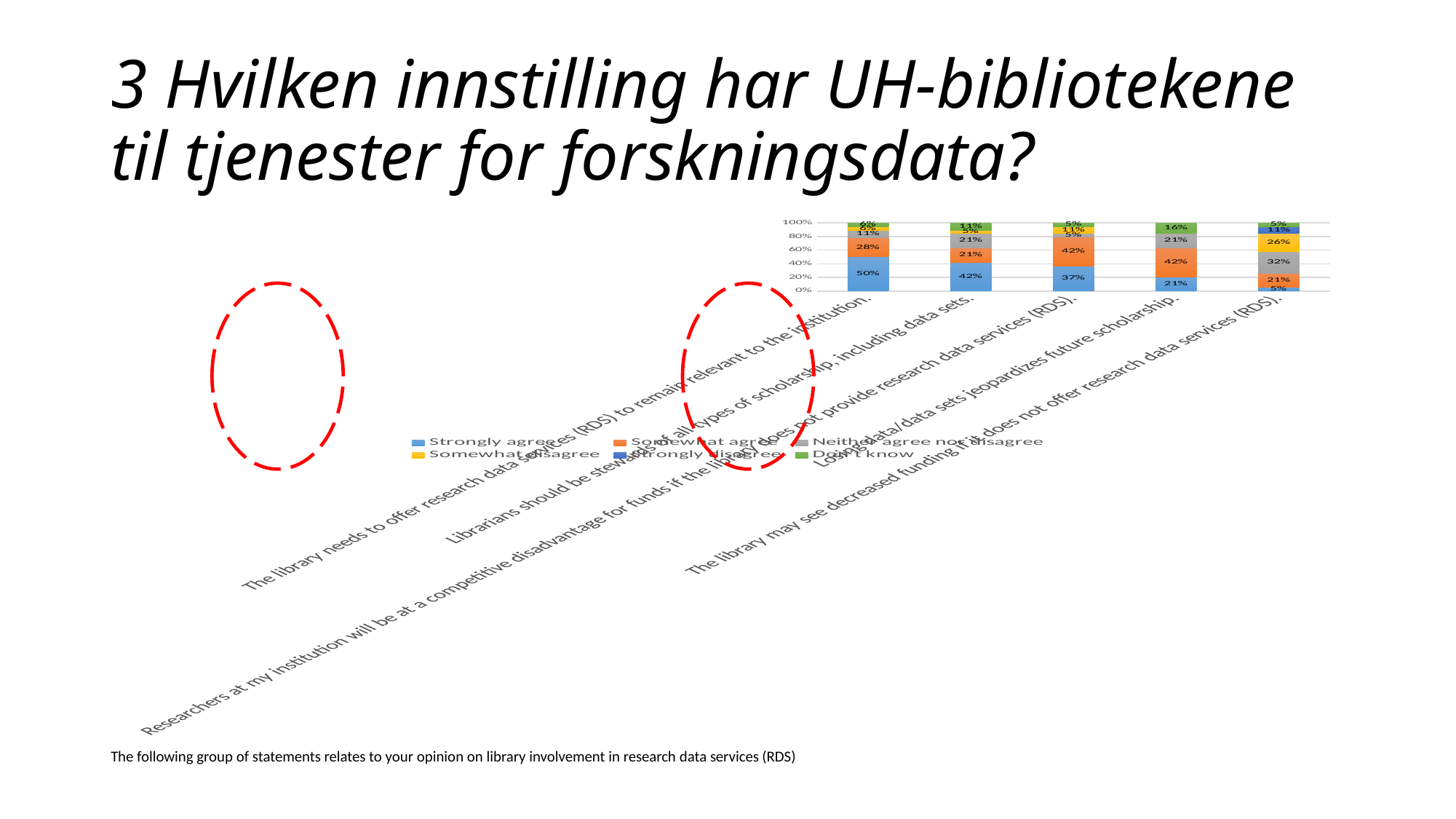
What is the Strongly agree value for the statement "The library may see decreased funding if it does not offer research data services (RDS)"? 5% What is the Neither agree nor disagree value for the statement "The library may see decreased funding if it does not offer research data services (RDS)"? 32% Which statement has the lowest Strongly agree share? The library may see decreased funding if it does not offer research data services (RDS). What percentage of respondents strongly agree that the library needs to offer research data services (RDS) to remain relevant to the institution? 50% What is the Don't know value for the statement "Loss of data/data sets jeopardizes future scholarship"? 16% What kind of chart is shown on the slide? Stacked bar chart Which statement has the highest Strongly agree share? The library needs to offer research data services (RDS) to remain relevant to the institution. How many statements (categories) are shown in the chart? 5 What is the Somewhat agree value for the statement "Loss of data/data sets jeopardizes future scholarship"? 42% How many response options does the legend list? 6 How many percentage points higher is the Strongly agree share for "The library needs to offer research data services (RDS) to remain relevant to the institution" than for "Librarians should be stewards of all types of scholarship, including data sets"? 8 percentage points Which statement has the larger Somewhat agree share: "Researchers at my institution will be at a competitive disadvantage for funds if the library does not provide research data services (RDS)" or "Librarians should be stewards of all types of scholarship, including data sets"? Researchers at my institution will be at a competitive disadvantage for funds if the library does not provide research data services (RDS).